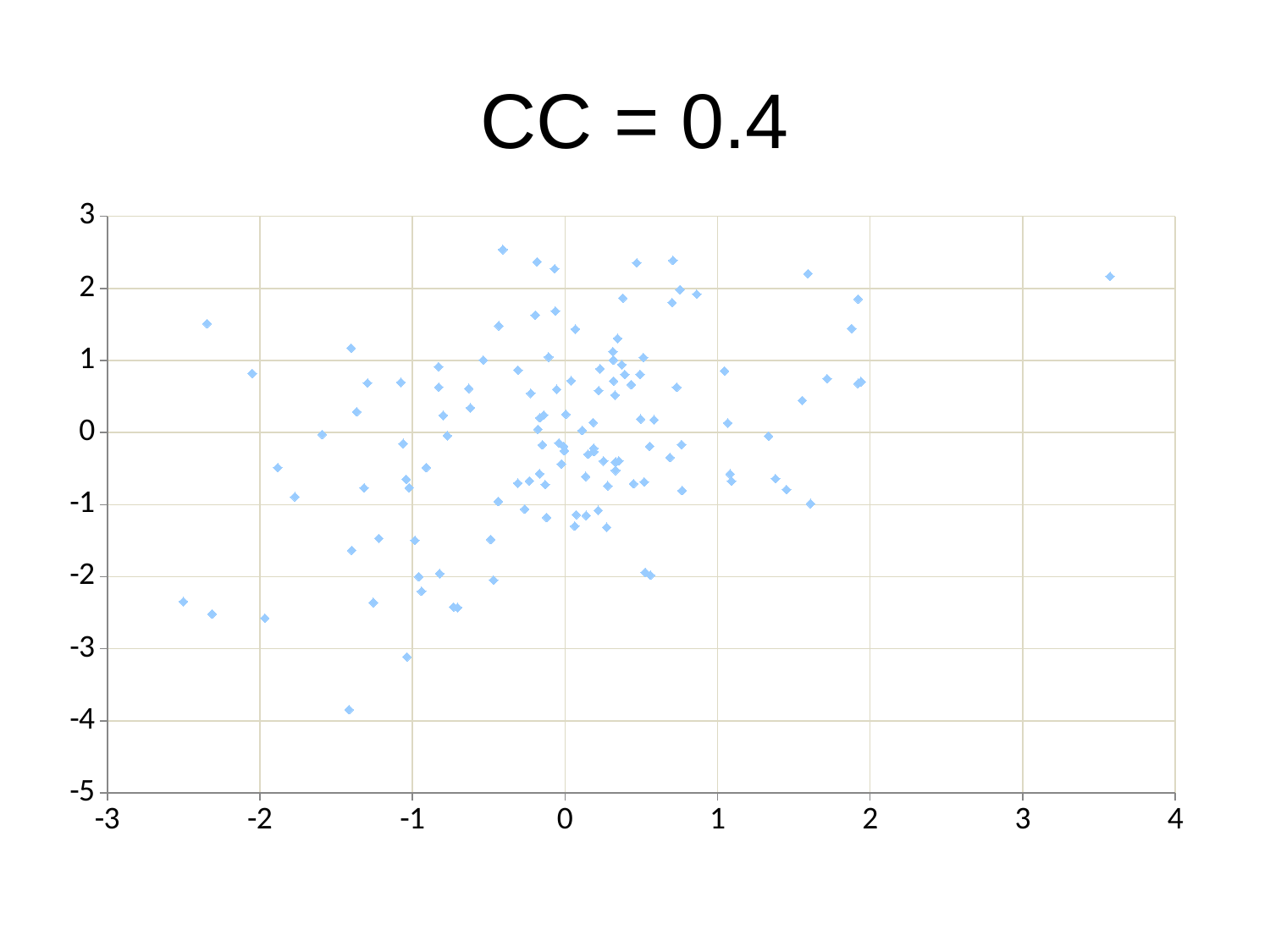
Is the y value of the rightmost point on the chart greater or less than 1? greater What is the maximum value shown on the x axis? 4 What is the title of the chart? CC = 0.4 Is the y value of the lowest point on the chart greater or less than -3? less Do the y values generally rise or fall as x increases across the chart? rise Is the x value of the leftmost point on the chart greater or less than -2? less What is the minimum value shown on the y axis? -5 What kind of chart is shown on the slide? scatter plot